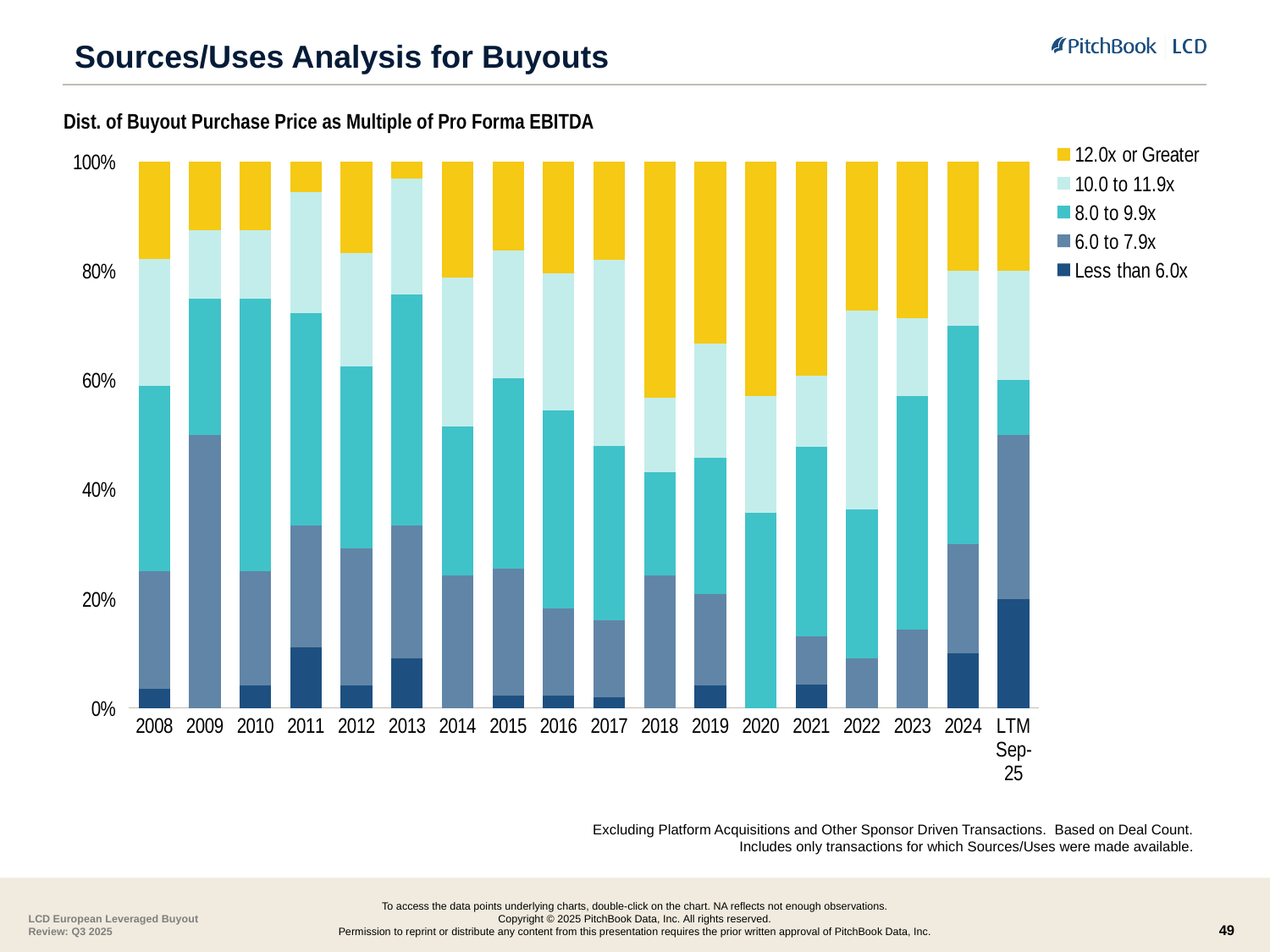
Is the share of 'Less than 6.0x' deals in LTM Sep-25 greater or less than 10%? greater What kind of chart is shown on the slide? Stacked bar chart Which year has the largest share of '6.0 to 7.9x' deals? 2009 Which legend entry is shown in yellow? 12.0x or Greater Which period has the largest share of 'Less than 6.0x' deals? LTM Sep-25 What is the title of the chart? Dist. of Buyout Purchase Price as Multiple of Pro Forma EBITDA How many series does the chart's legend list? 5 Is the share of '12.0x or Greater' deals in 2011 greater or less than 20%? less Which year has a larger share of '12.0x or Greater' deals, 2013 or 2018? 2018 Which year has a larger share of '6.0 to 7.9x' deals, 2008 or 2009? 2009 How many categories (years/periods) are shown on the x axis of the chart? 18 Is the share of '8.0 to 9.9x' deals in 2020 greater or less than 20%? greater